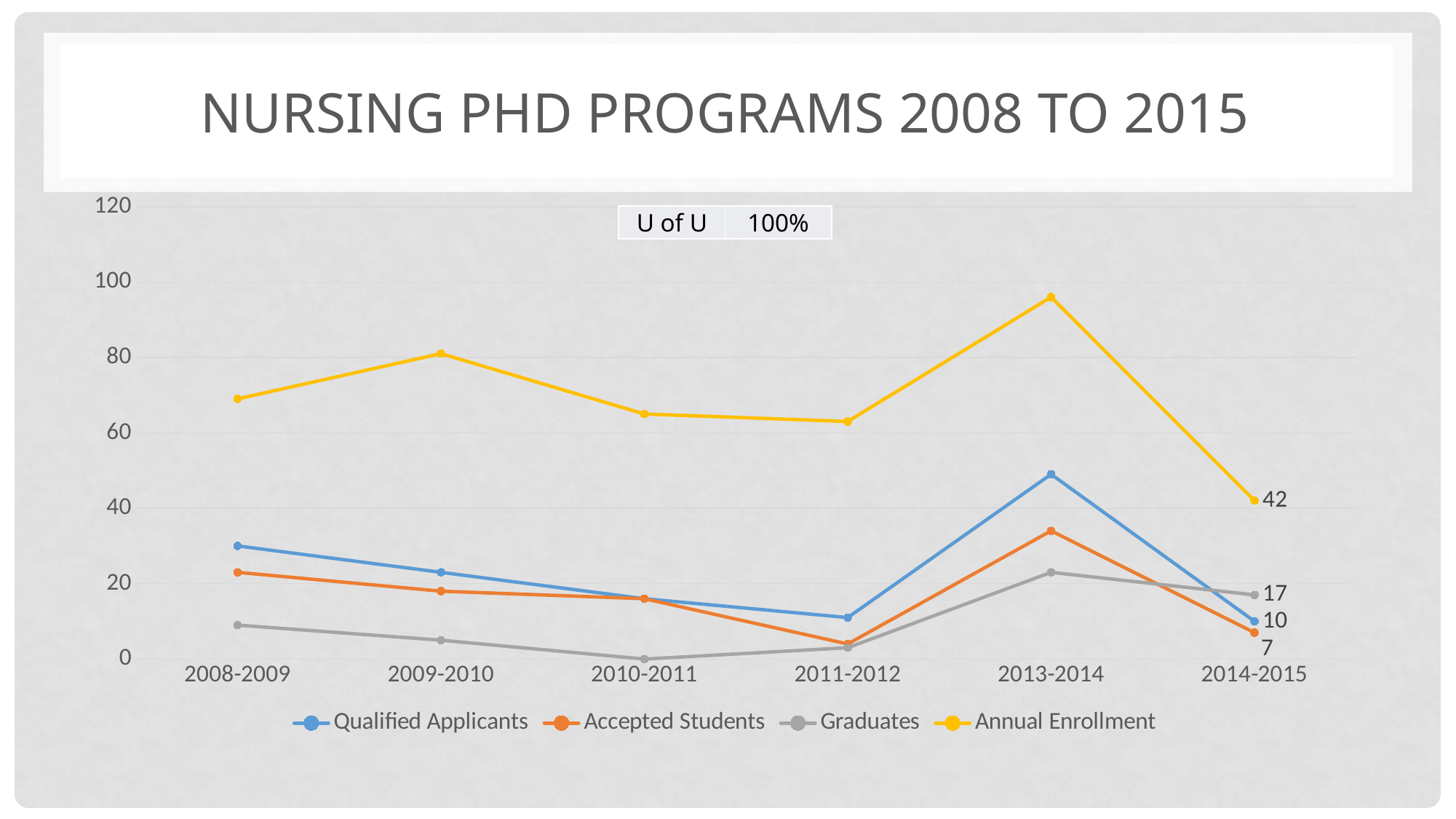
How many periods are shown on the x axis? 6 In 2014-2015, which is larger: Graduates or Qualified Applicants? Graduates What is the value for Accepted Students in 2014-2015? 7 What is the difference between Annual Enrollment and Graduates in 2014-2015? 25 In which period is the Graduates value lowest? 2010-2011 In which period is Annual Enrollment highest? 2013-2014 What is the value for Graduates in 2014-2015? 17 What is the value for Annual Enrollment in 2014-2015? 42 Is the value for Annual Enrollment in 2013-2014 greater or less than 80? greater How many series does the legend list? 4 What is the value for Qualified Applicants in 2014-2015? 10 What kind of chart is shown on the slide? line chart